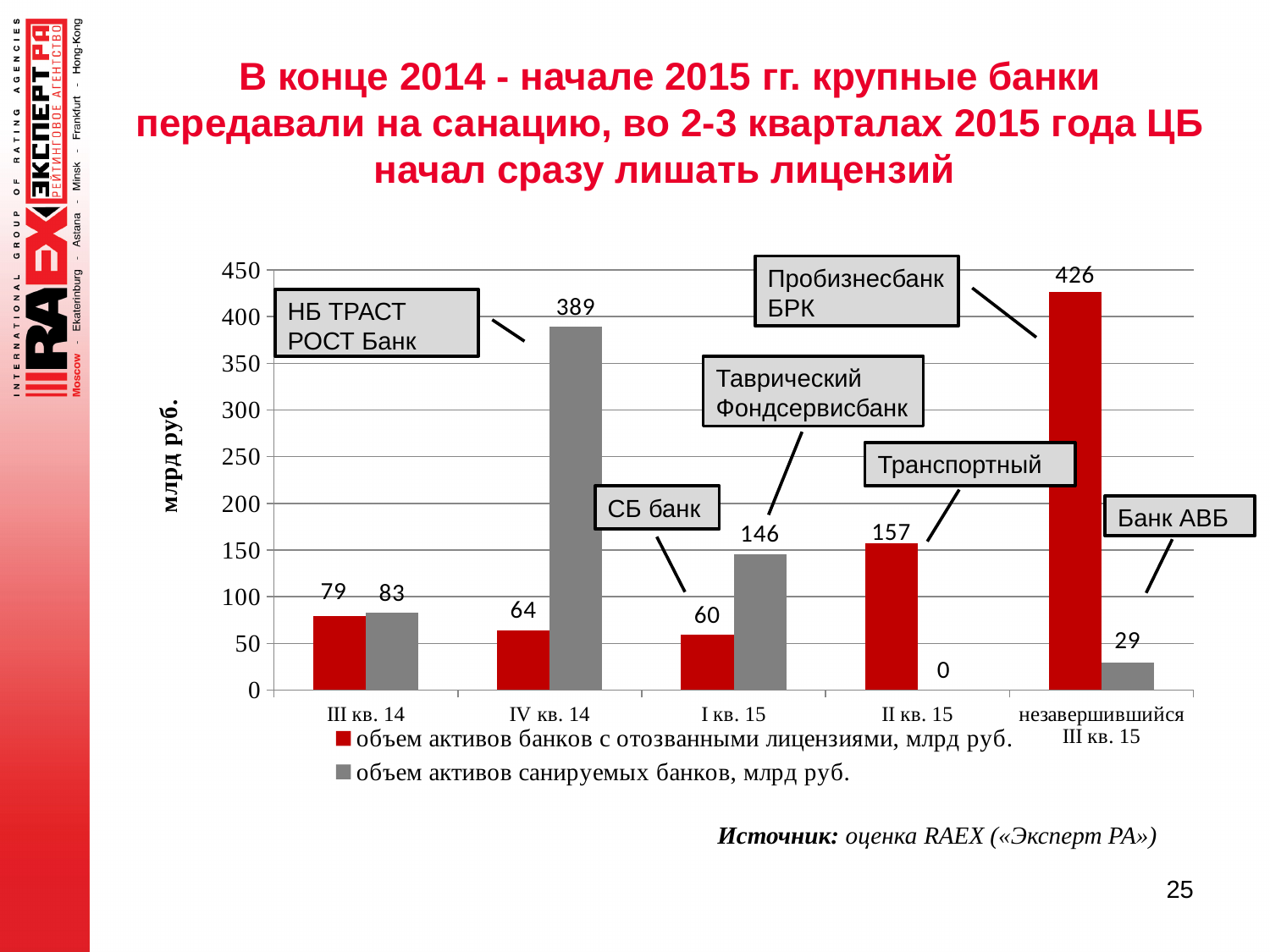
How many periods are shown on the x axis? 5 In which period is объем активов санируемых банков the lowest? II кв. 15 What is the total of the two series in III кв. 14? 162 What kind of chart is shown on the slide? bar chart In which period is объем активов банков с отозванными лицензиями the highest? незавершившийся III кв. 15 What is the value for объем активов банков с отозванными лицензиями in IV кв. 14? 64 What is the value for объем активов санируемых банков in II кв. 15? 0 What is the difference between объем активов санируемых банков and объем активов банков с отозванными лицензиями in IV кв. 14? 325 What is the y-axis label of the chart? млрд руб. How many series does the legend list? 2 Which is larger in незавершившийся III кв. 15: объем активов банков с отозванными лицензиями or объем активов санируемых банков? объем активов банков с отозванными лицензиями What is the value for объем активов санируемых банков in I кв. 15? 146